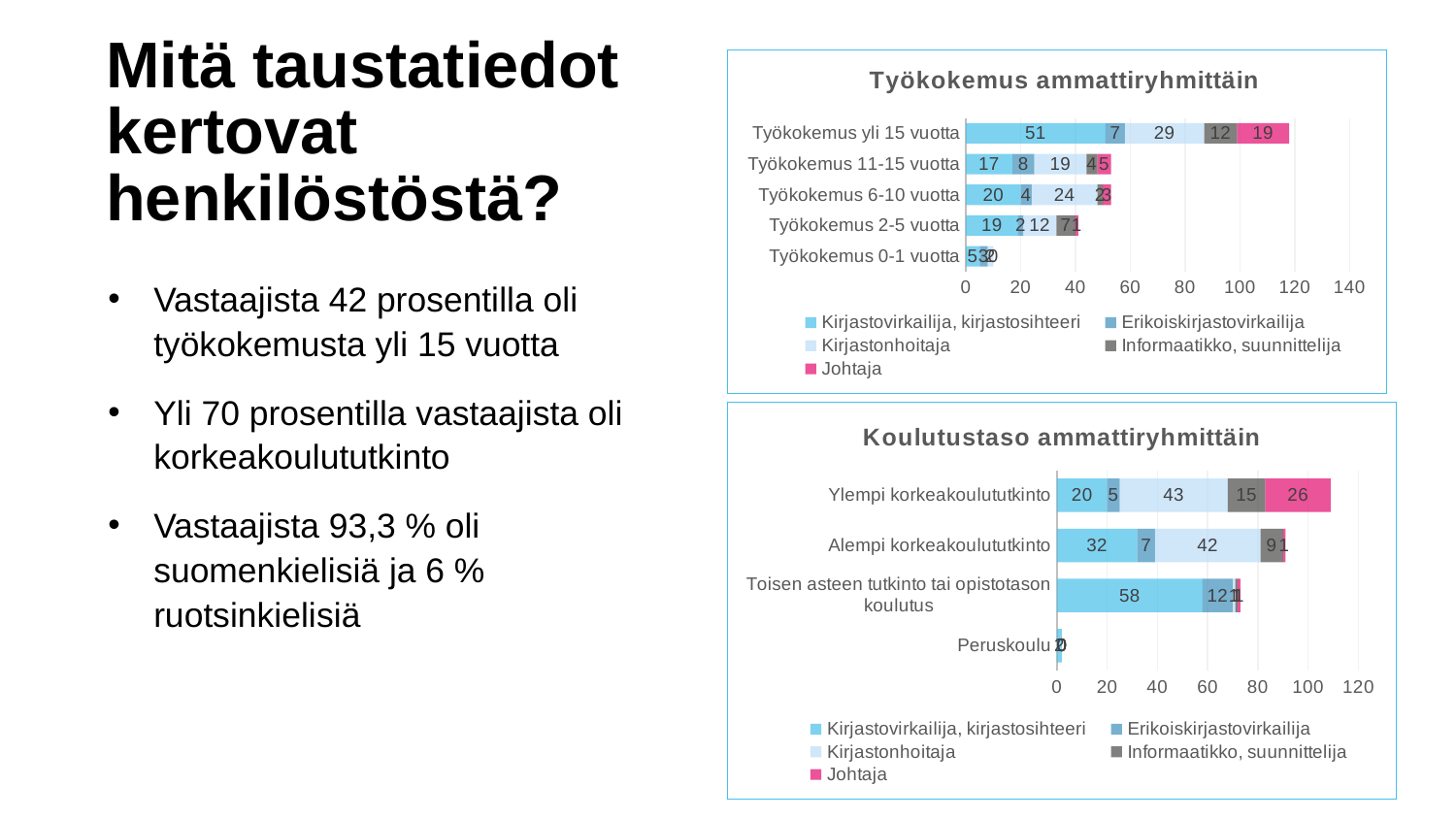
In the chart titled "Koulutustaso ammattiryhmittäin", what is the value for Kirjastovirkailija, kirjastosihteeri in the "Toisen asteen tutkinto tai opistotason koulutus" category? 58 In the chart titled "Työkokemus ammattiryhmittäin", what is the value for Kirjastonhoitaja in the "Työkokemus 6-10 vuotta" category? 24 In the chart titled "Koulutustaso ammattiryhmittäin", what is the value for Johtaja in the "Ylempi korkeakoulututkinto" category? 26 In the chart titled "Työkokemus ammattiryhmittäin", how many series does the legend list? 5 In the chart titled "Koulutustaso ammattiryhmittäin", how many categories are shown on the vertical axis? 4 In the chart titled "Työkokemus ammattiryhmittäin", what is the total of the stacked bar for "Työkokemus yli 15 vuotta"? 118 In the chart titled "Työkokemus ammattiryhmittäin", is the total for "Työkokemus 2-5 vuotta" greater or less than 60? less What kind of chart is the chart titled "Koulutustaso ammattiryhmittäin"? Stacked bar chart In the chart titled "Koulutustaso ammattiryhmittäin", what is the difference between the Kirjastovirkailija, kirjastosihteeri values for "Alempi korkeakoulututkinto" and "Ylempi korkeakoulututkinto"? 12 In the chart titled "Työkokemus ammattiryhmittäin", what is the value for Kirjastovirkailija, kirjastosihteeri in the "Työkokemus yli 15 vuotta" category? 51 In the chart titled "Koulutustaso ammattiryhmittäin", what is the total of the stacked bar for "Ylempi korkeakoulututkinto"? 109 In the chart titled "Työkokemus ammattiryhmittäin", which category has the longest stacked bar? Työkokemus yli 15 vuotta